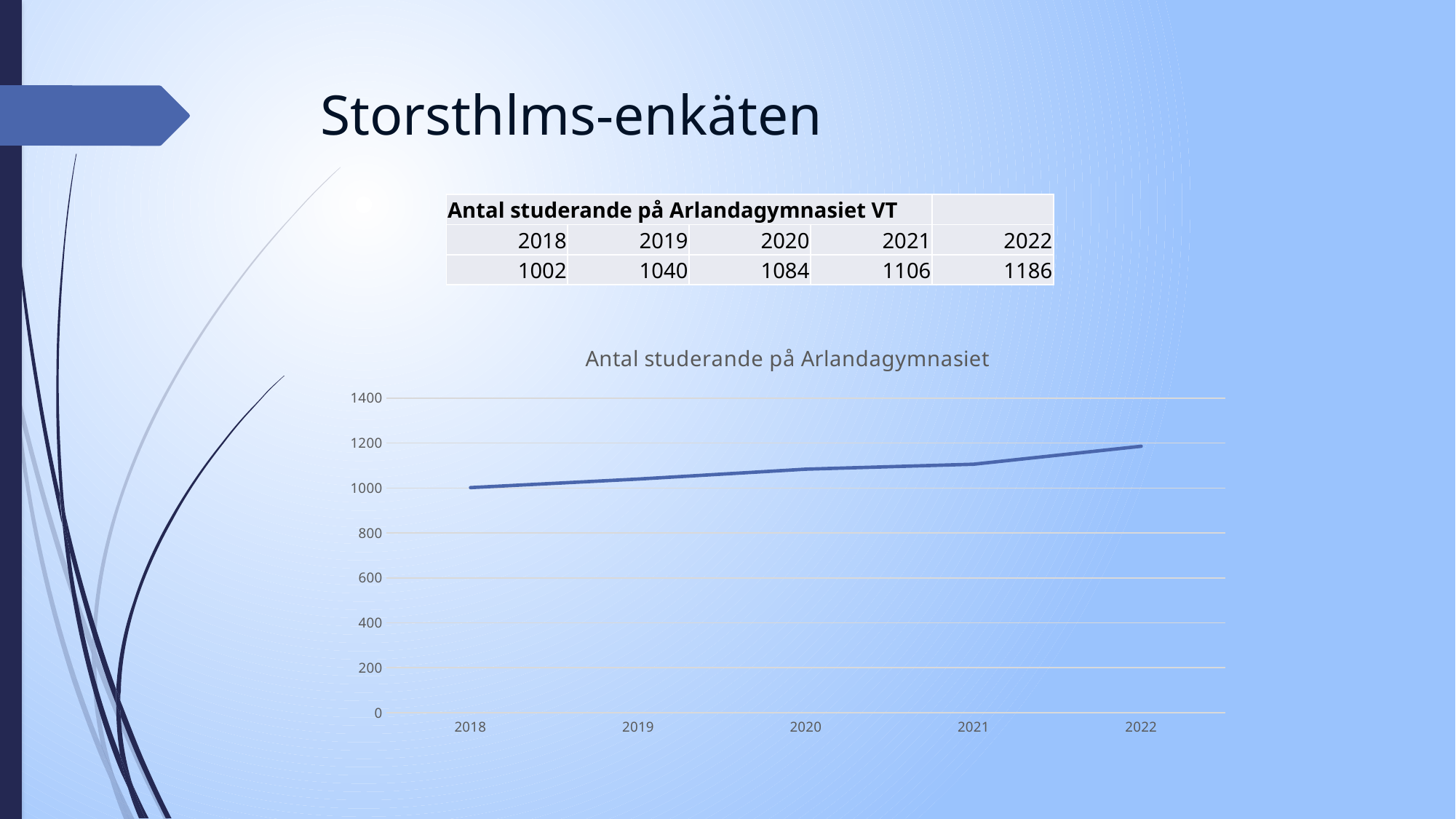
What kind of chart is shown on the slide? line chart What is the value for 2018 in the chart? 1002 Which is larger, the value for 2019 or the value for 2021? 2021 What is the difference between the values for 2022 and 2018? 184 What is the value for 2022 in the chart? 1186 Do the values in the chart rise or fall from 2018 to 2022? rise What is the value for 2020 in the chart? 1084 Which year has the lowest value in the chart? 2018 Which year has the highest value in the chart? 2022 What is the title of the chart? Antal studerande på Arlandagymnasiet Is the value for 2021 greater or less than 1200? less How many years are plotted on the x axis of the chart? 5